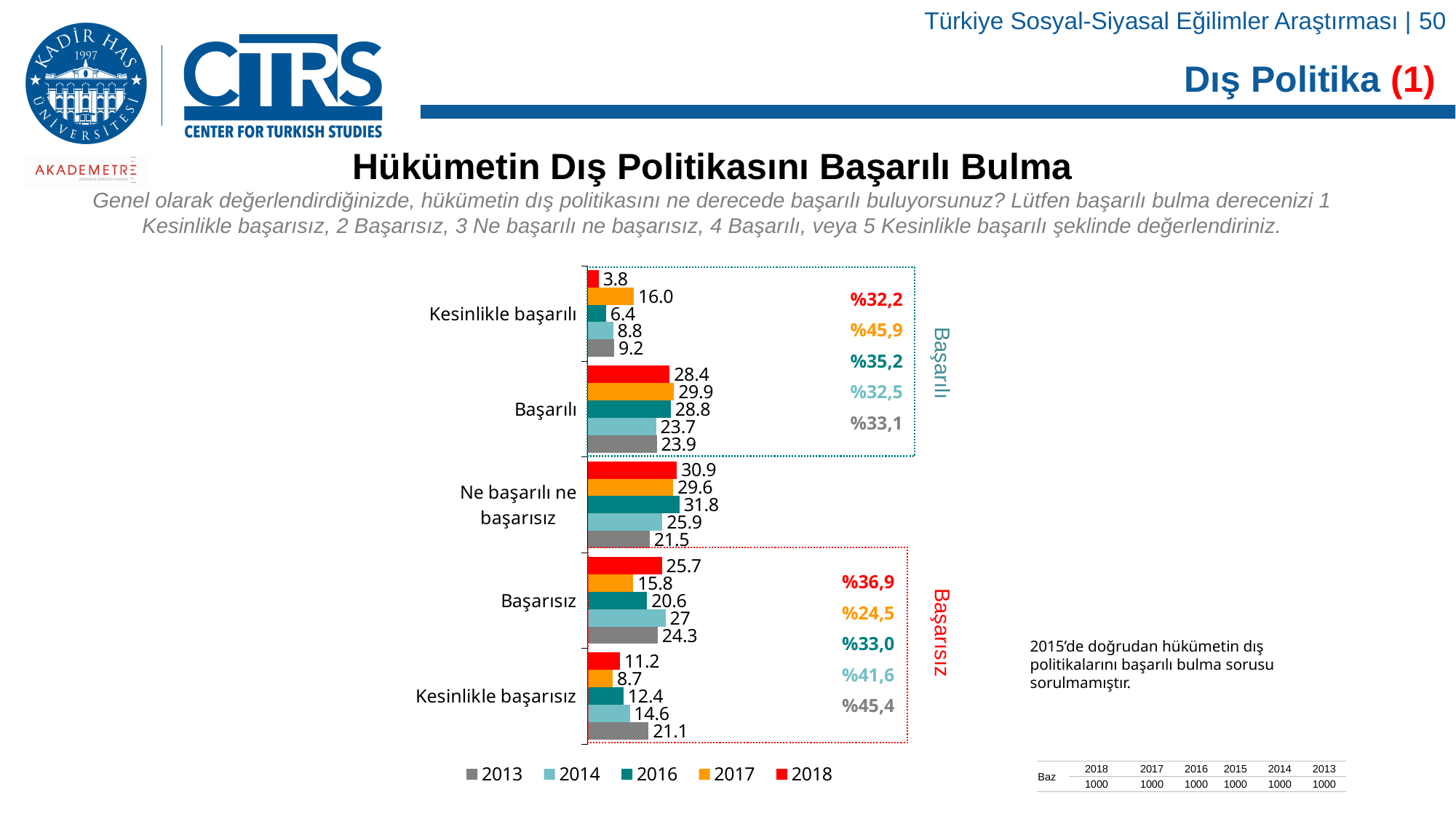
What combined 'Başarısız' percentage is shown for 2013 in the summary box? %45,4 What is the difference between the 2018 and 2017 values for 'Başarısız'? 9.9 How many series does the legend list? 5 Which year has the lowest value for 'Ne başarılı ne başarısız'? 2013 Which is larger for 'Kesinlikle başarısız': the 2014 value or the 2016 value? 2014 What is the 2018 value for 'Kesinlikle başarılı'? 3.8 What is the 2013 value for 'Kesinlikle başarısız'? 21.1 What is the 2017 value for 'Başarısız'? 15.8 What combined 'Başarılı' percentage is shown for 2017 in the summary box? %45,9 How many response categories are plotted on the chart? 5 Which year has the highest value for 'Kesinlikle başarılı'? 2017 What type of chart is shown on the slide? bar chart